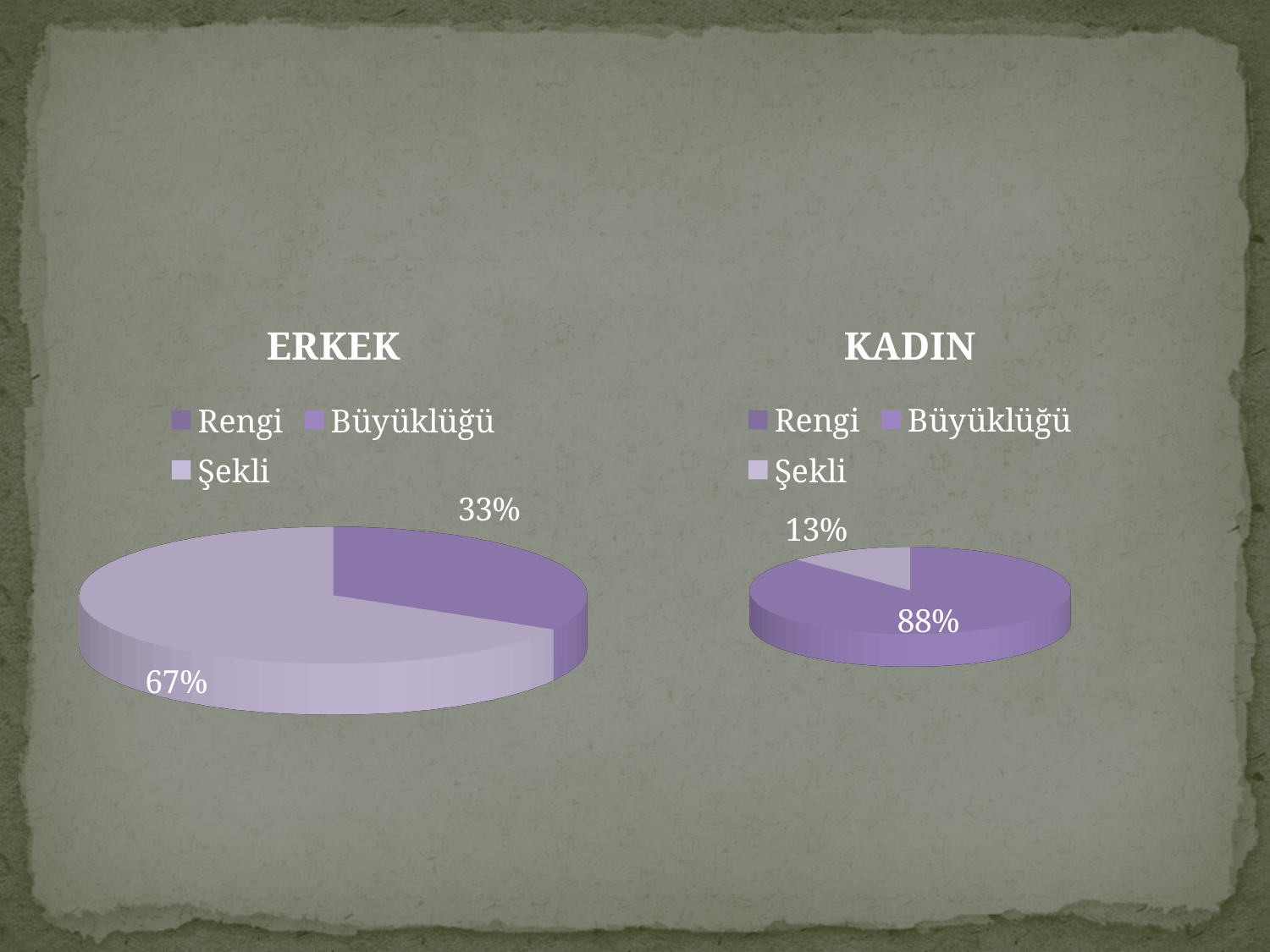
What is the difference between the Şekli share in the ERKEK chart and the Şekli share in the KADIN chart? 54% In the KADIN chart, what is the value of the largest slice? 88% In the KADIN chart, what is the value of the smallest slice? 13% In the KADIN chart, what share does the Şekli slice have? 13% Which chart has the larger Şekli share, ERKEK or KADIN? ERKEK What are the legend entries of the ERKEK chart? Rengi, Büyüklüğü, Şekli In the ERKEK chart, what is the value of the largest slice? 67% In the ERKEK chart, what is the value of the smallest labelled slice? 33% How many entries does the legend of the KADIN chart list? 3 In the ERKEK chart, what share does the Şekli slice have? 67% What kind of chart is the ERKEK chart? pie chart What kind of chart is the KADIN chart? pie chart